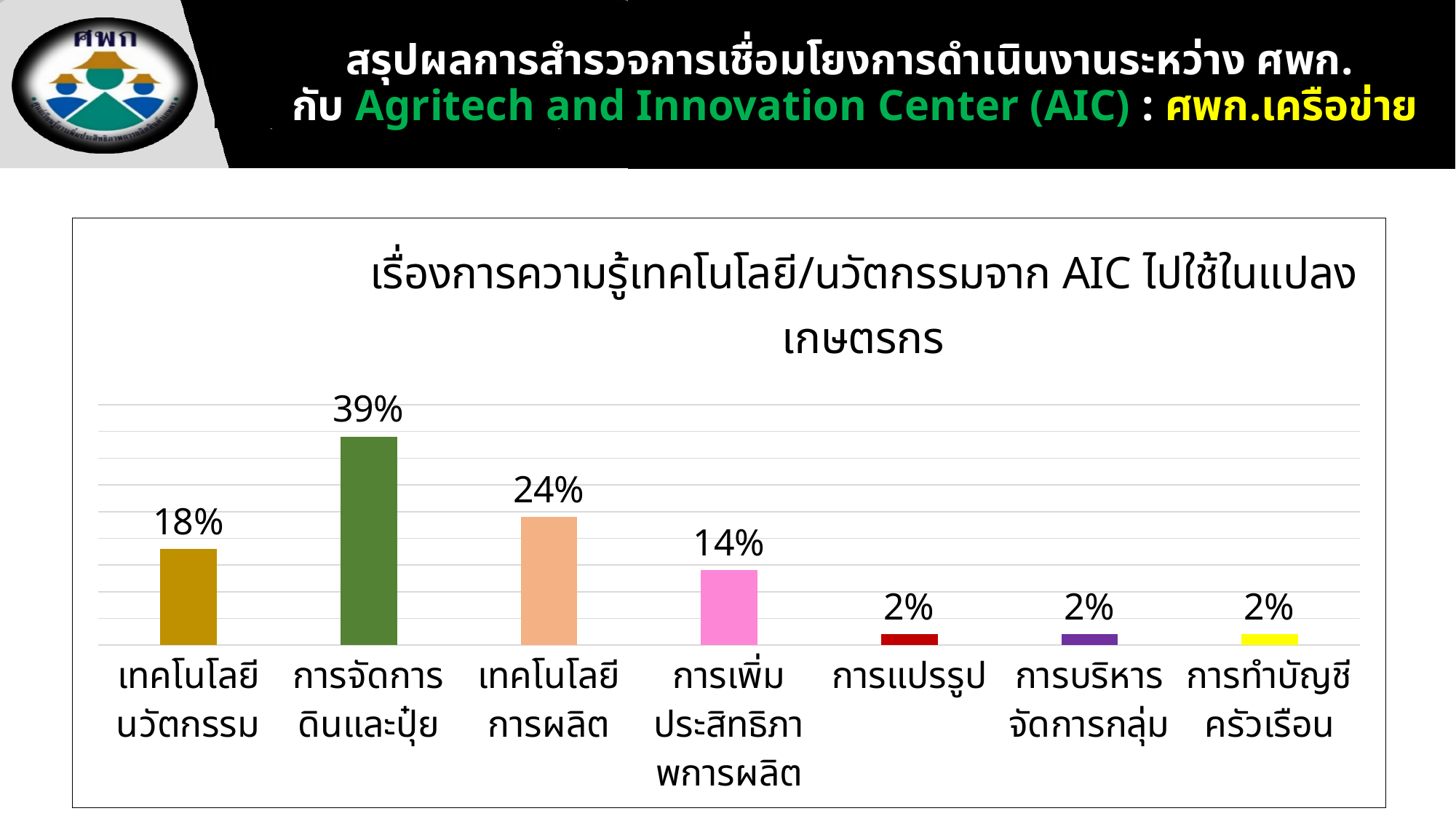
What is the value for การทำบัญชีครัวเรือน? 2% What is the title of the chart? เรื่องการความรู้เทคโนโลยี/นวัตกรรมจาก AIC ไปใช้ในแปลงเกษตรกร What is the difference between the values for เทคโนโลยีนวัตกรรม and การเพิ่มประสิทธิภาพการผลิต? 4% What is the difference between the values for การจัดการดินและปุ๋ย and เทคโนโลยีการผลิต? 15% What is the value for เทคโนโลยีนวัตกรรม? 18% What is the value for เทคโนโลยีการผลิต? 24% What type of chart is shown on the slide? bar chart Which category has the highest value? การจัดการดินและปุ๋ย What is the value for การเพิ่มประสิทธิภาพการผลิต? 14% What is the value for การจัดการดินและปุ๋ย? 39% How many categories are shown in the chart? 7 Which is larger, the value for เทคโนโลยีการผลิต or the value for เทคโนโลยีนวัตกรรม? เทคโนโลยีการผลิต